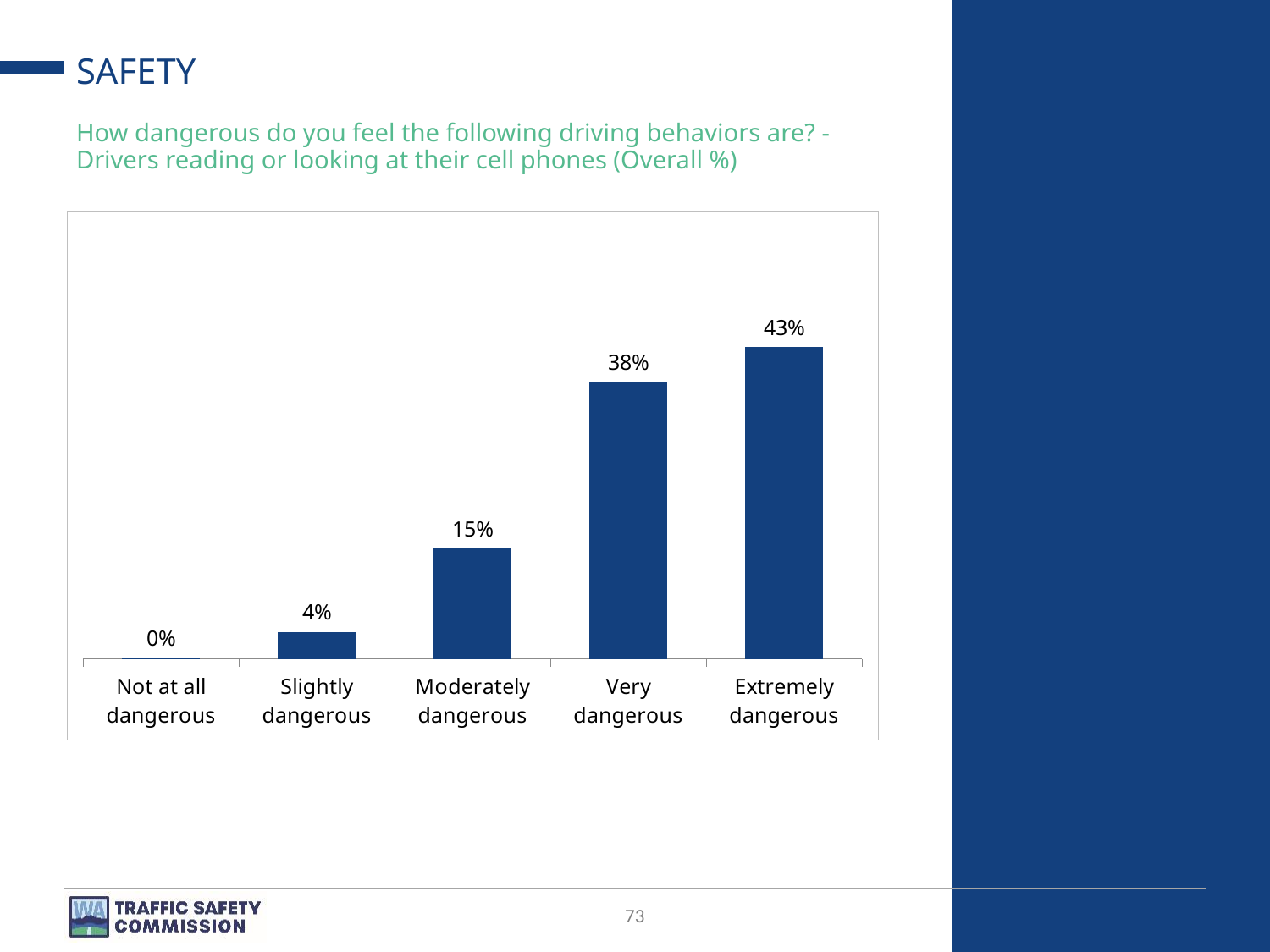
What is the value for "Moderately dangerous"? 15% What is the difference between the "Extremely dangerous" and "Very dangerous" values? 5% What is the value for "Slightly dangerous"? 4% Do the values rise or fall moving from left to right along the x axis? Rise What percentage of respondents rated drivers reading or looking at their cell phones as "Extremely dangerous"? 43% How many categories are shown on the x axis? 5 Which is larger, the value for "Very dangerous" or the value for "Moderately dangerous"? Very dangerous Which category has the highest value? Extremely dangerous Which category has the lowest value? Not at all dangerous What is the value for "Not at all dangerous"? 0% What kind of chart is shown on the slide? Bar chart What is the difference between the "Very dangerous" and "Moderately dangerous" values? 23%